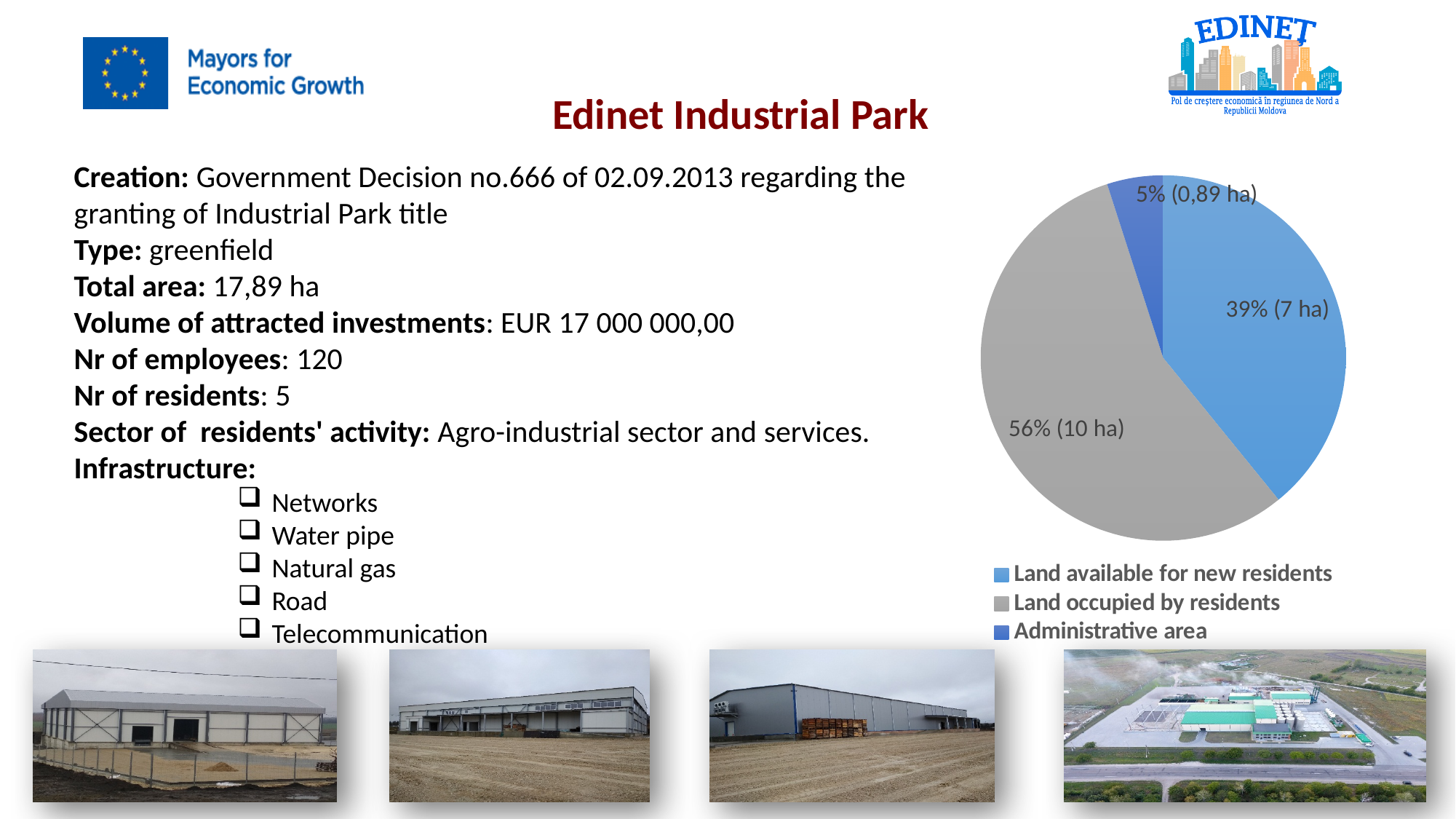
Which category has the smallest slice of the pie chart? Administrative area How many slices does the pie chart have? 3 How many hectares are labelled for 'Administrative area' in the pie chart? 0,89 ha What share of the pie is 'Administrative area'? 5% How many hectares are labelled for 'Land occupied by residents' in the pie chart? 10 ha How many entries does the legend of the pie chart list? 3 What kind of chart is shown on the slide? pie chart What share of the pie is 'Land occupied by residents'? 56% What is the difference in percentage points between 'Land occupied by residents' and 'Land available for new residents'? 17 percentage points How many hectares are labelled for 'Land available for new residents' in the pie chart? 7 ha Which category has the largest slice of the pie chart? Land occupied by residents What share of the pie is 'Land available for new residents'? 39%